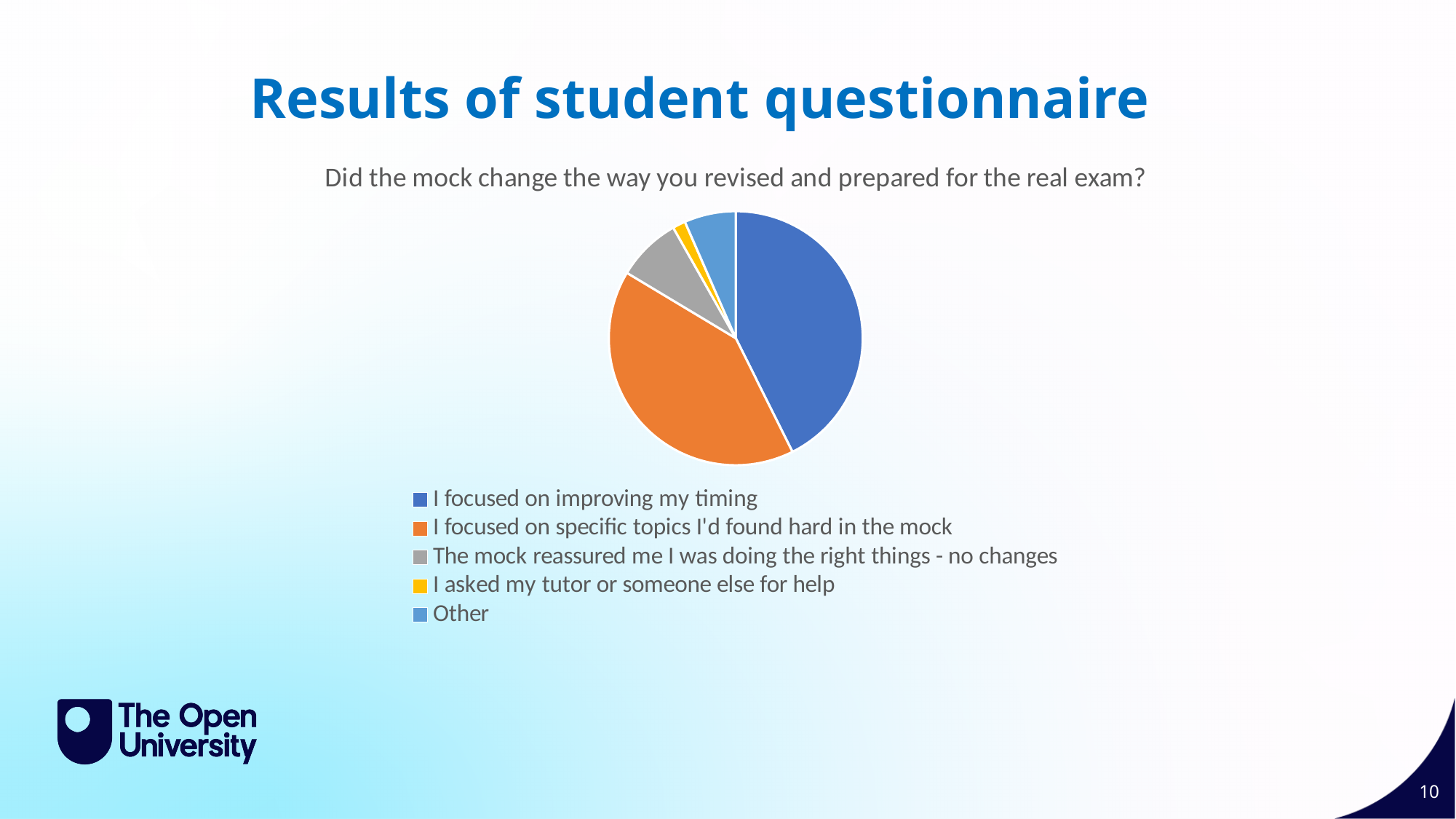
What is the title of the pie chart? Did the mock change the way you revised and prepared for the real exam? What kind of chart is shown on the slide? pie chart Which slice is larger: 'Other' or 'I asked my tutor or someone else for help'? Other Which slice is larger: 'I focused on improving my timing' or 'The mock reassured me I was doing the right things - no changes'? I focused on improving my timing Which slice is larger: 'I focused on improving my timing' or 'Other'? I focused on improving my timing Which category is shown in yellow in the pie chart? I asked my tutor or someone else for help Which category has the smallest slice of the pie chart? I asked my tutor or someone else for help How many categories (slices) does the pie chart have? 5 How many entries does the legend of the pie chart list? 5